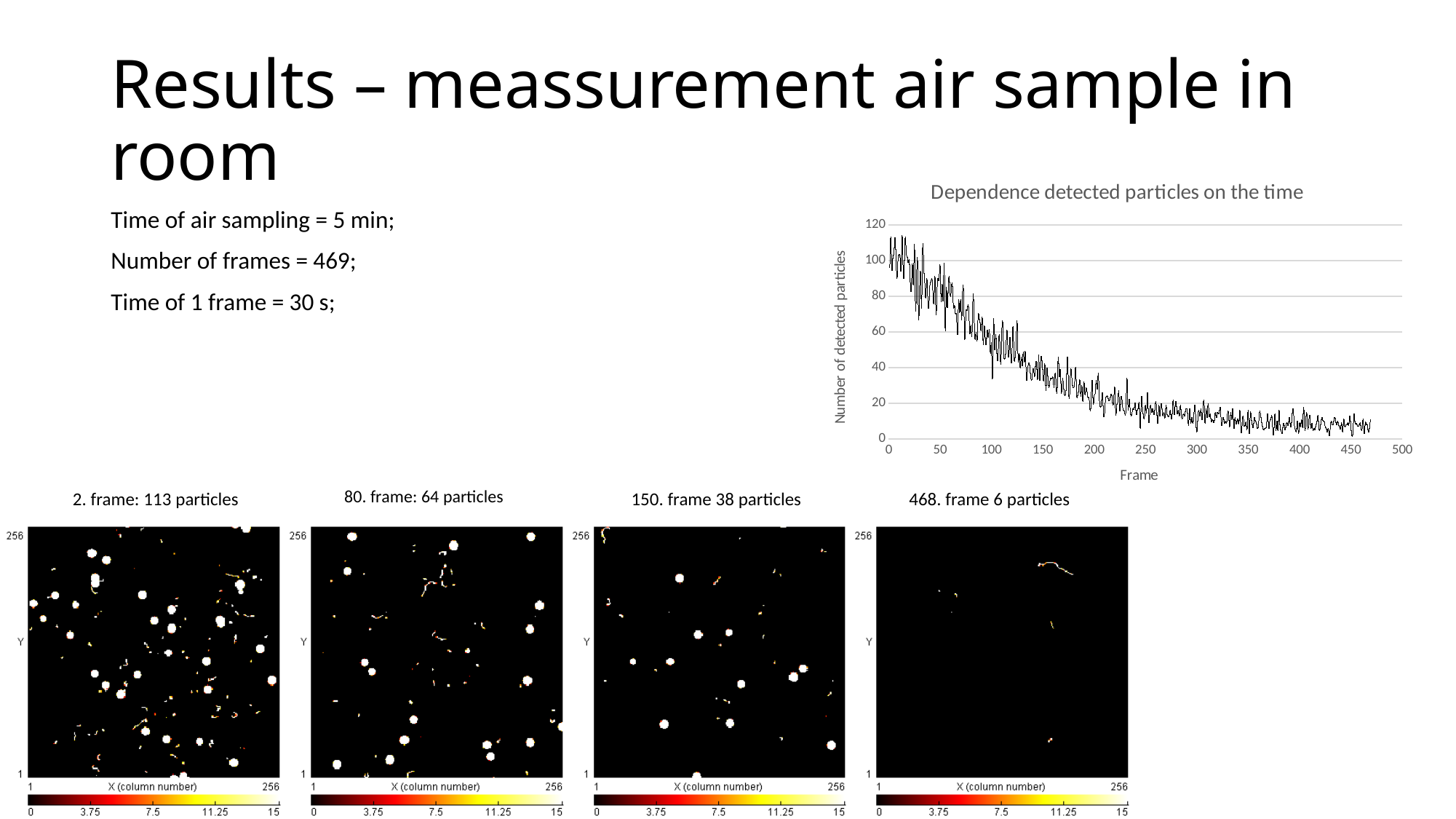
According to the slide, what is the difference between the number of particles in frame 2 and in frame 468? 107 Do the values in the chart rise or fall as the frame number increases? fall According to the slide, how many particles were detected in frame 2? 113 In the chart, is the number of detected particles near frame 0 greater or less than 80? greater According to the slide, how many particles were detected in frame 468? 6 In the chart, is the number of detected particles at frame 100 greater or less than 20? greater In the chart, is the number of detected particles at frame 200 greater or less than 60? less What is the title of the chart on the slide? Dependence detected particles on the time What kind of chart is "Dependence detected particles on the time"? line chart What is the label of the y axis of the chart? Number of detected particles